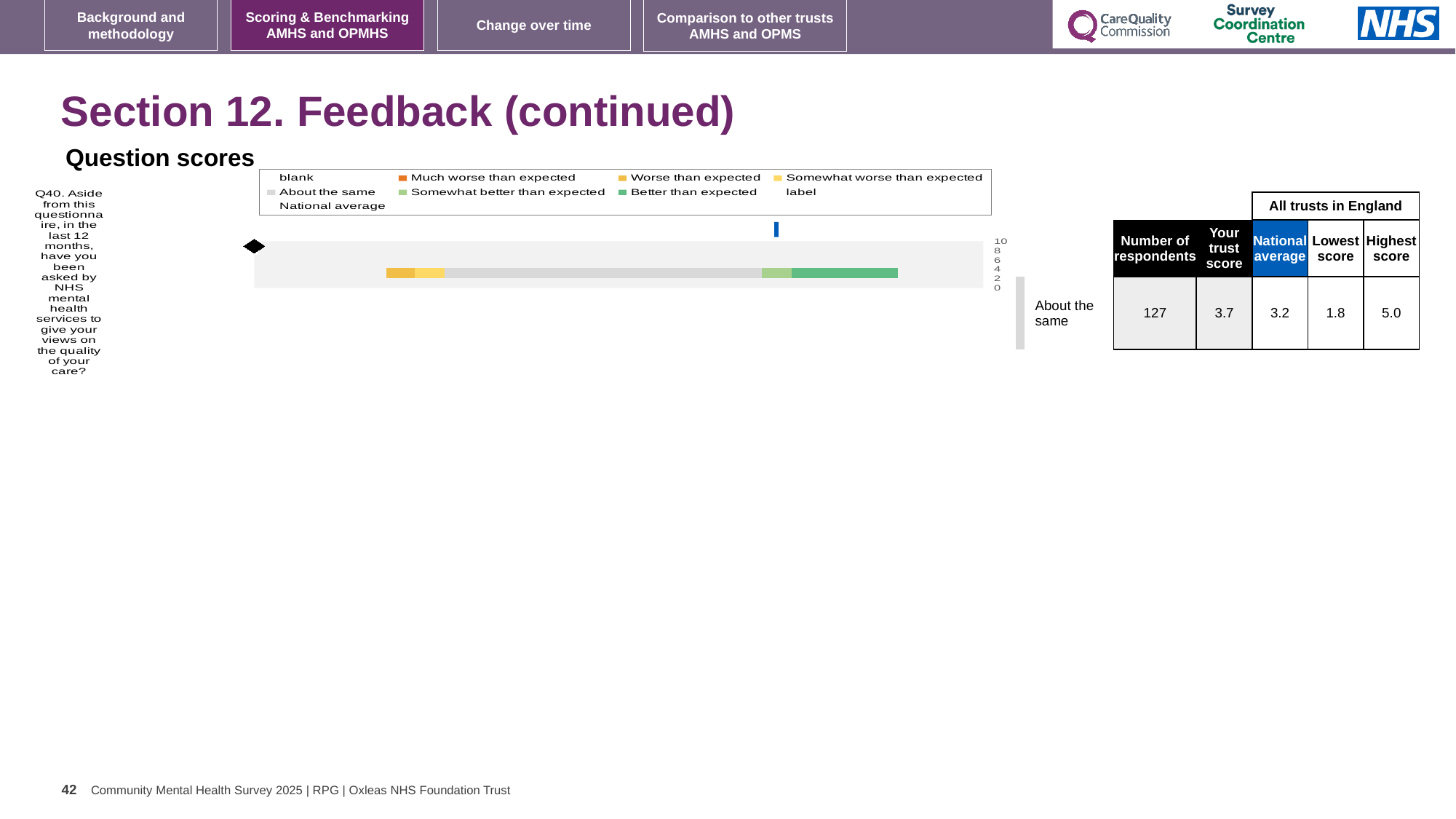
In the table beside the Q40 chart, what is the National average? 3.2 For Q40, what is the difference between the Highest score and the Lowest score? 3.2 In the table beside the Q40 chart, what is 'Your trust score'? 3.7 In the table beside the Q40 chart, what is the number of respondents? 127 What kind of chart is shown under 'Question scores'? bar chart In the table beside the Q40 chart, what is the Lowest score among all trusts in England? 1.8 In the table beside the Q40 chart, what is the Highest score among all trusts in England? 5.0 Which question number is plotted in the Question scores chart? Q40 What rating label is shown to the right of the Q40 bar? About the same For Q40, which is larger: Your trust score or the National average? Your trust score How many entries does the legend of the Question scores chart list? 9 How many questions are plotted in the Question scores chart? 1